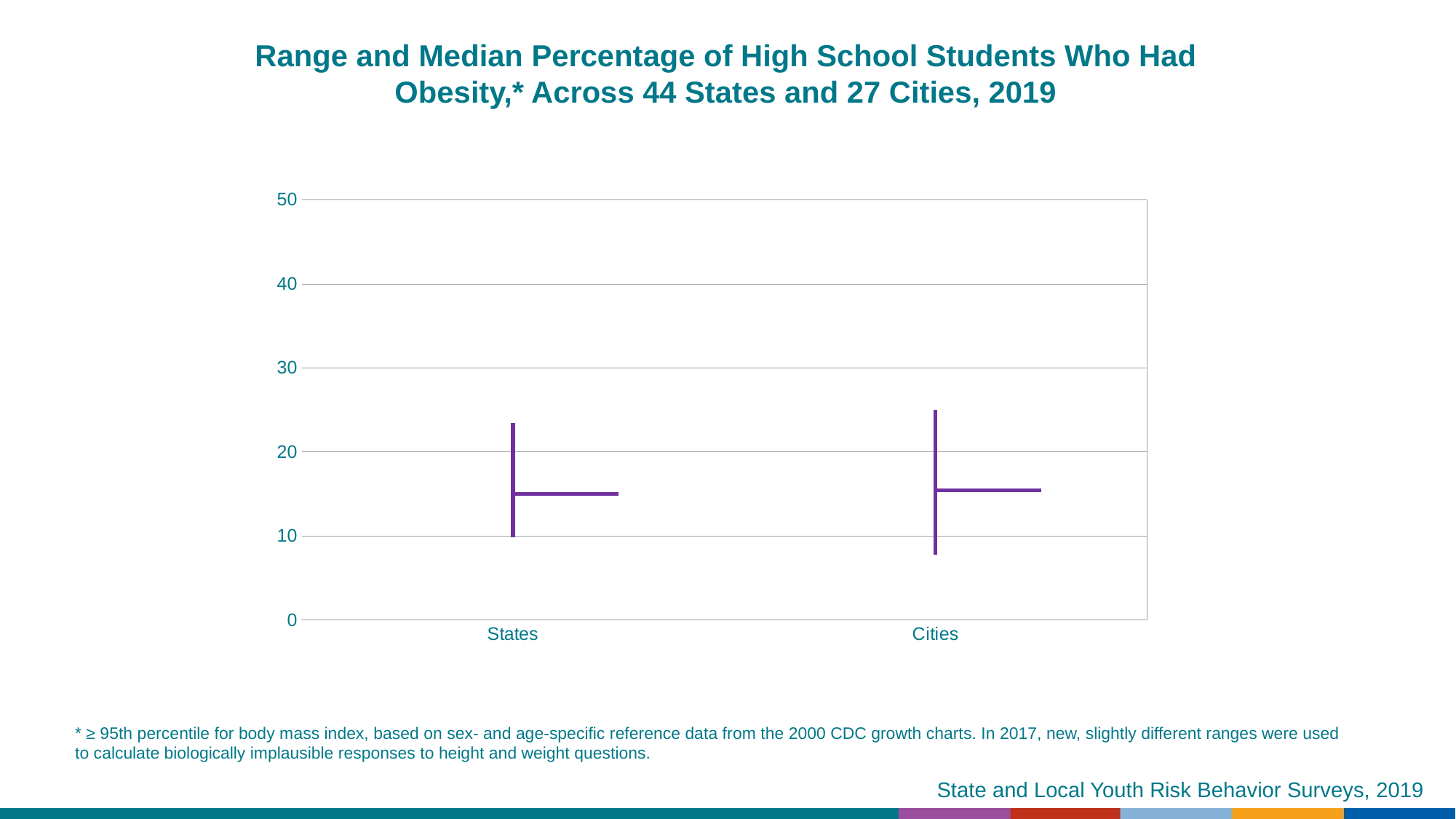
Is the median value for States greater or less than 20? less Is the top of the range for States greater or less than 30? less Is the top of the range for Cities greater or less than 20? greater How many categories are shown on the x axis of the chart? 2 What are the two categories shown on the x axis? States and Cities Which category has the wider range, States or Cities? Cities What is the title of the chart? Range and Median Percentage of High School Students Who Had Obesity,* Across 44 States and 27 Cities, 2019 Which category has the lower bottom of its range, States or Cities? Cities What is the highest value shown on the y axis? 50